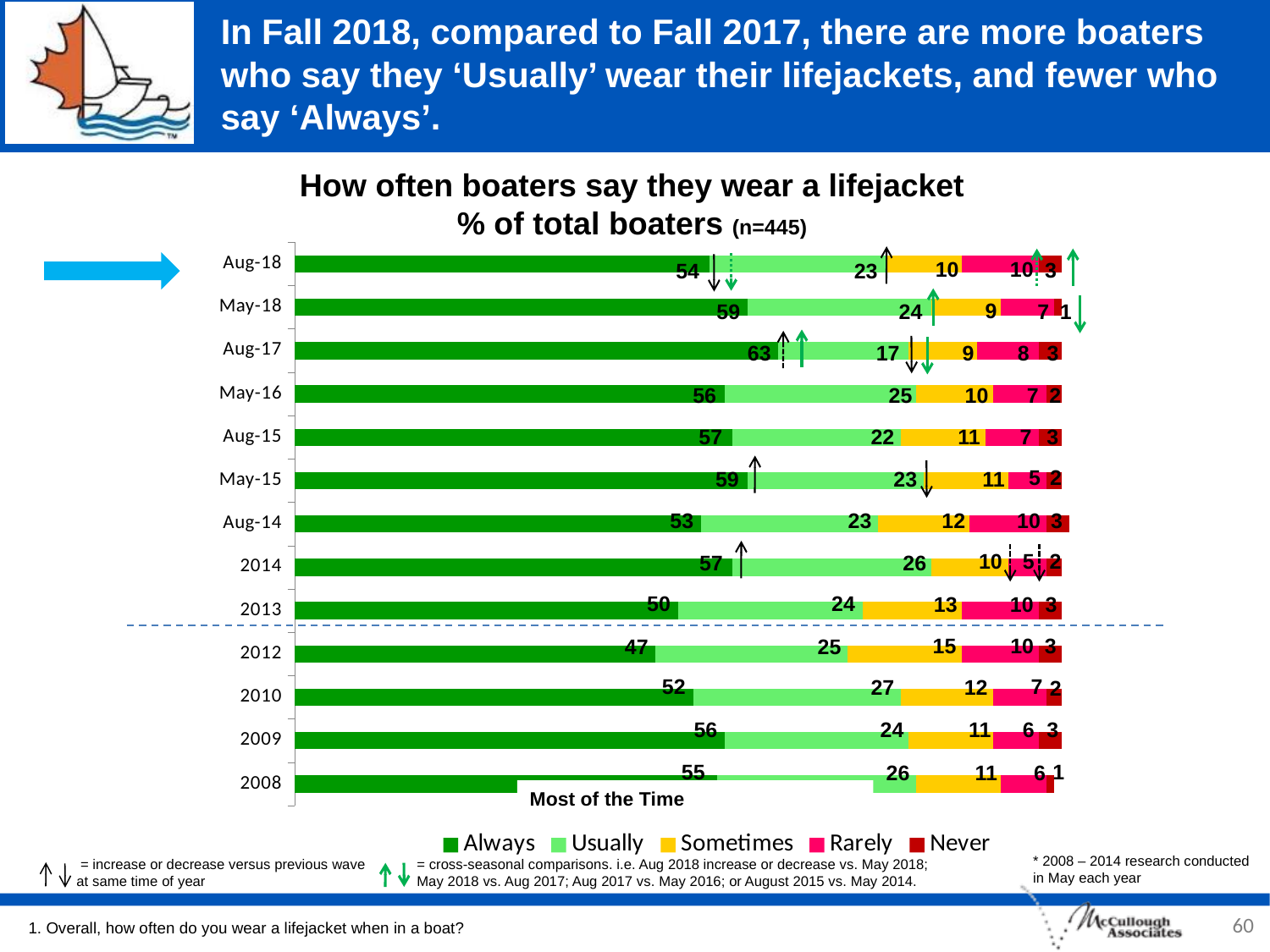
Which period has the larger 'Usually' value, Aug-18 or Aug-17? Aug-18 What is the 'Usually' value for Aug-18? 23 How many time periods (bars) are shown on the chart? 13 By how many percentage points did the 'Always' value fall from Aug-17 to Aug-18? 9 In which period was the 'Always' share highest? Aug-17 What is the 'Rarely' value for Aug-18? 10 What kind of chart is shown on the slide? Stacked bar chart What percentage of boaters said they 'Always' wear a lifejacket in Aug-17? 63 How many series does the legend list? 5 What is the 'Sometimes' value for 2012? 15 What is the total of the stacked bar for May-18? 100 In which period was the 'Always' share lowest? 2012